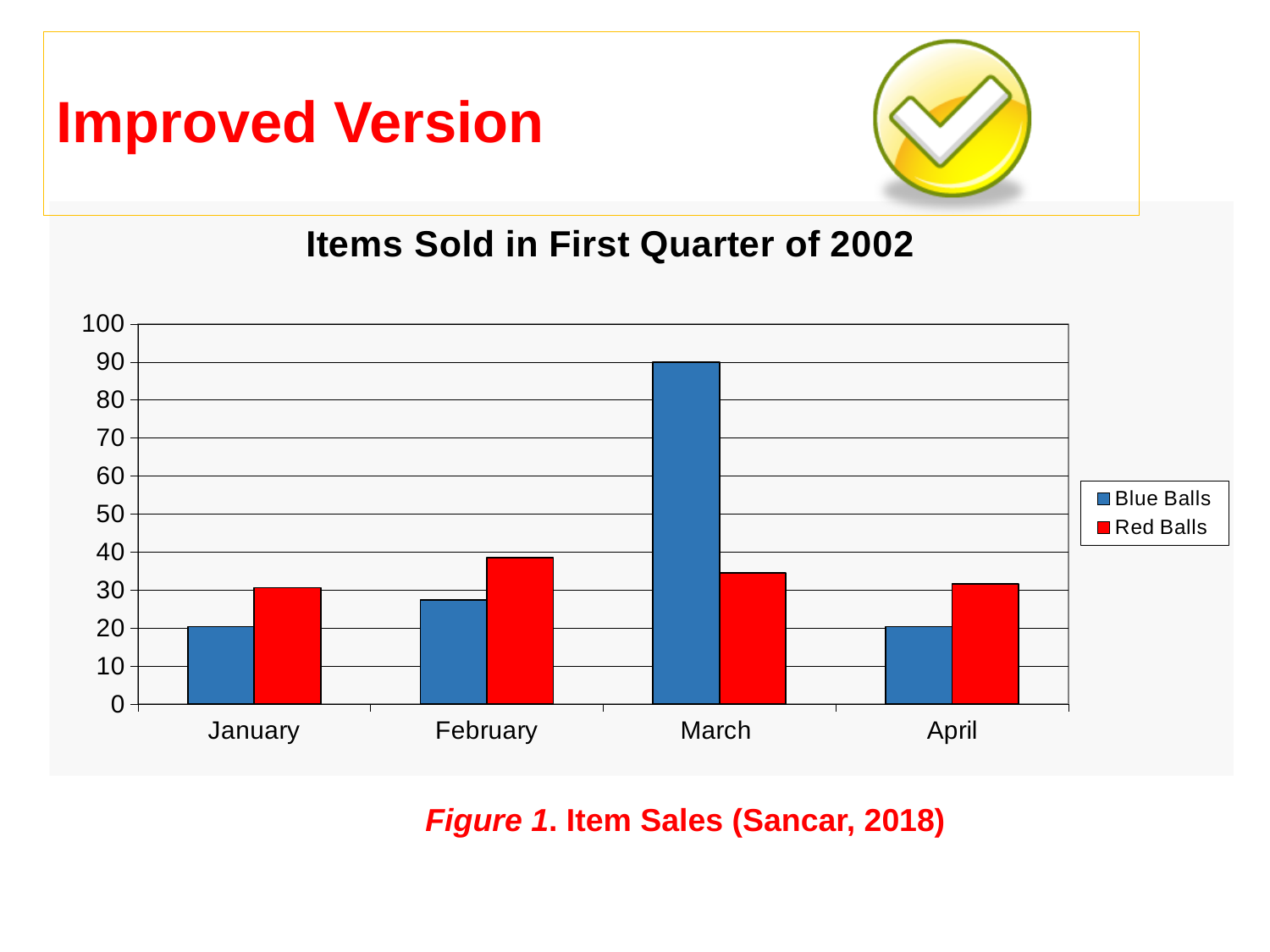
What are the two series named in the legend? Blue Balls and Red Balls Which is larger, the Red Balls value in February or the Red Balls value in January? February How many series does the legend list? 2 In which month is the Blue Balls value highest? March In which month is the Red Balls value highest? February Is the Blue Balls value for February greater or less than 20? greater Is the Blue Balls value for March greater or less than 80? greater What is the title of the chart? Items Sold in First Quarter of 2002 In March, which series has the larger value, Blue Balls or Red Balls? Blue Balls How many months are shown on the x axis? 4 What kind of chart is shown on the slide? Bar chart Is the Red Balls value for January greater or less than 40? less